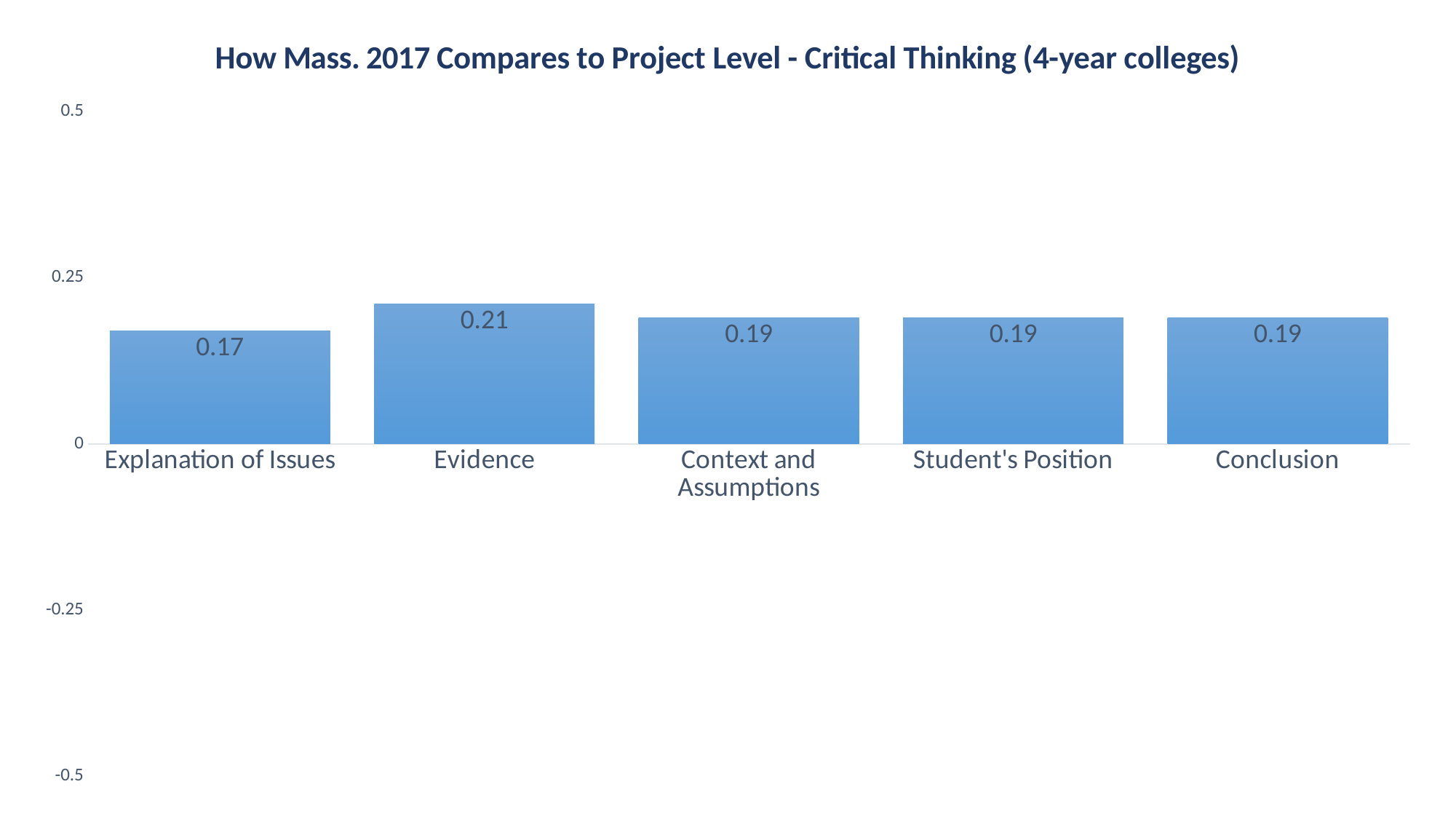
Which category has the lowest value? Explanation of Issues Which is larger, the value for Evidence or the value for Conclusion? Evidence What is the value for Student's Position? 0.19 How many categories are shown on the x axis? 5 Which category has the highest value? Evidence What kind of chart is shown on the slide? bar chart What is the value for Explanation of Issues? 0.17 Is the value for Evidence greater or less than 0.25? less What is the value for Conclusion? 0.19 What is the difference between the values for Evidence and Explanation of Issues? 0.04 What is the value for Evidence? 0.21 What is the difference between the values for Context and Assumptions and Explanation of Issues? 0.02